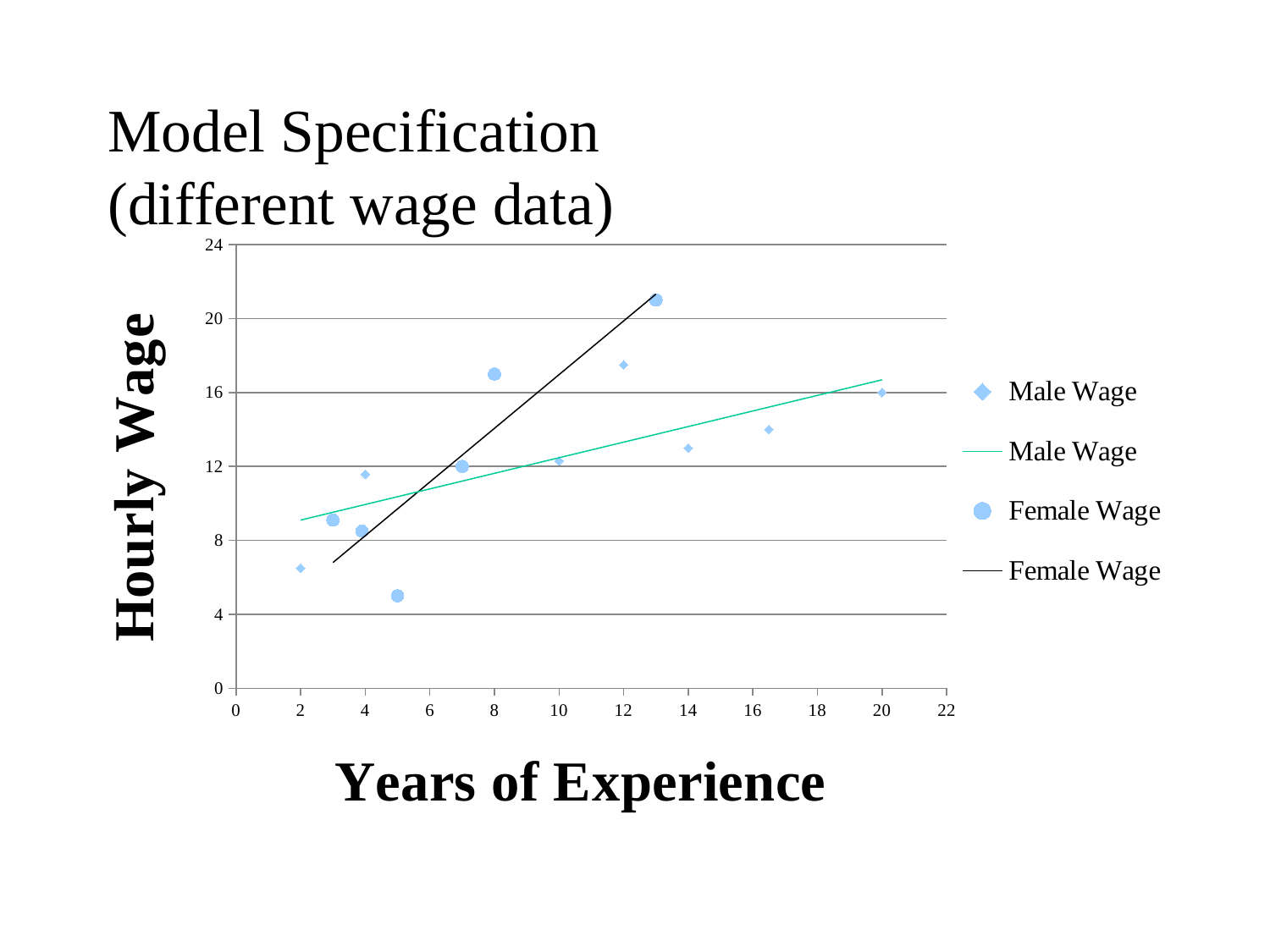
What kind of chart is shown on the slide? scatter chart Is the Female Wage value at 13 years of experience greater or less than 20? greater What is the title of the chart's horizontal axis? Years of Experience How many entries does the chart's legend list? 4 How many Female Wage data points (circles) are plotted on the chart? 6 At 4 years of experience, which is larger: the Male Wage point or the Female Wage point? Male Wage How many Male Wage data points (diamonds) are plotted on the chart? 7 Is the Male Wage value at 2 years of experience greater or less than 8? less Is the Male Wage value at 12 years of experience greater or less than 16? greater Which series contains the highest plotted hourly wage on the chart? Female Wage Does the Male Wage trend line rise or fall as years of experience increase? rise